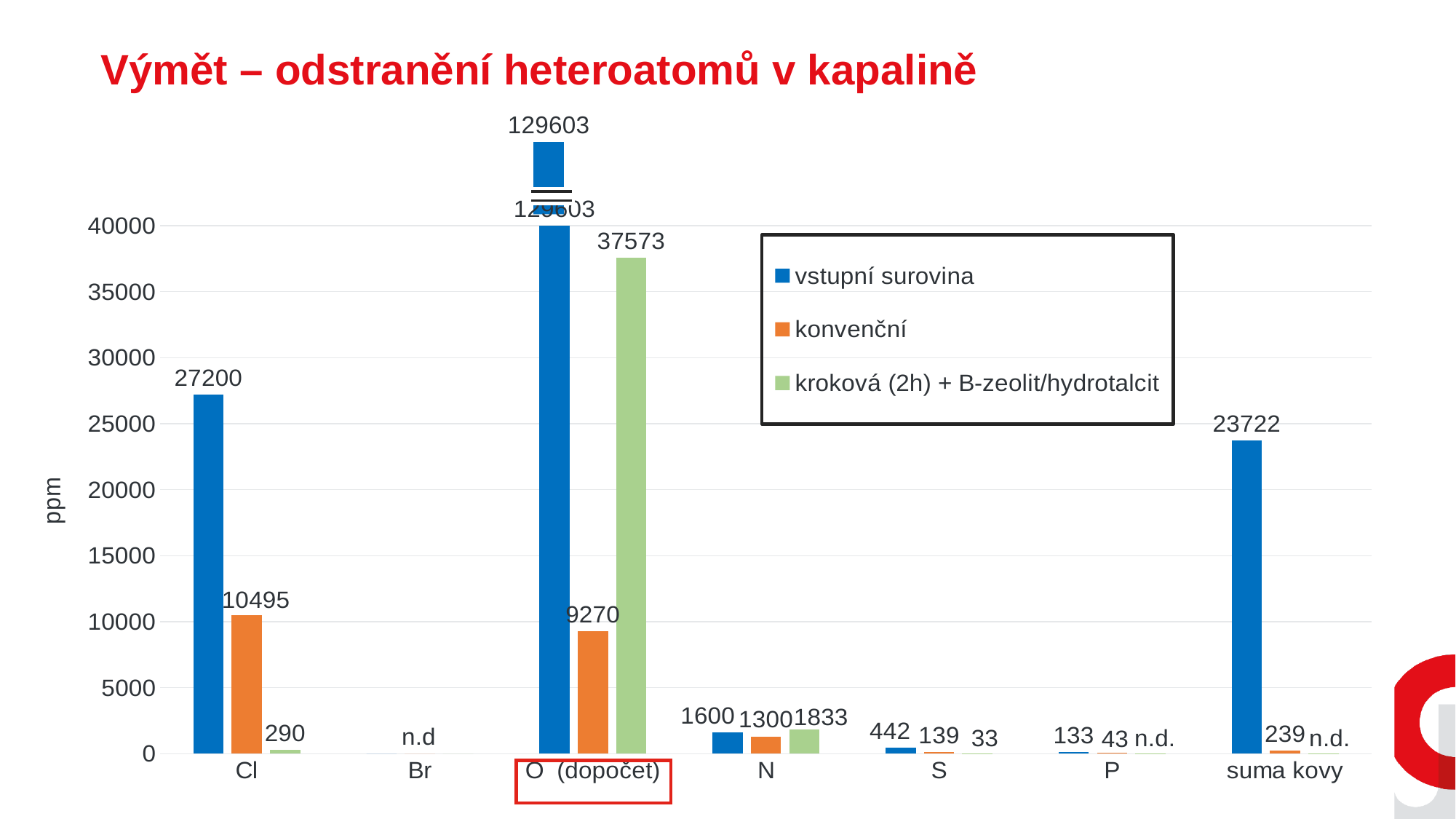
What is the y-axis label of the chart? ppm What is the value of vstupní surovina for suma kovy? 23722 Which category has the highest vstupní surovina value? O (dopočet) What is the value of kroková (2h) + B-zeolit/hydrotalcit for S? 33 What is the value of vstupní surovina for Cl? 27200 Which is larger for N: the konvenční value or the kroková (2h) + B-zeolit/hydrotalcit value? kroková (2h) + B-zeolit/hydrotalcit How many series does the legend list? 3 What label is shown for the Br category instead of a value? n.d What is the difference between the vstupní surovina and konvenční values for Cl? 16705 What is the value of konvenční for O (dopočet)? 9270 What type of chart is shown on the slide? bar chart What is the value of kroková (2h) + B-zeolit/hydrotalcit for O (dopočet)? 37573